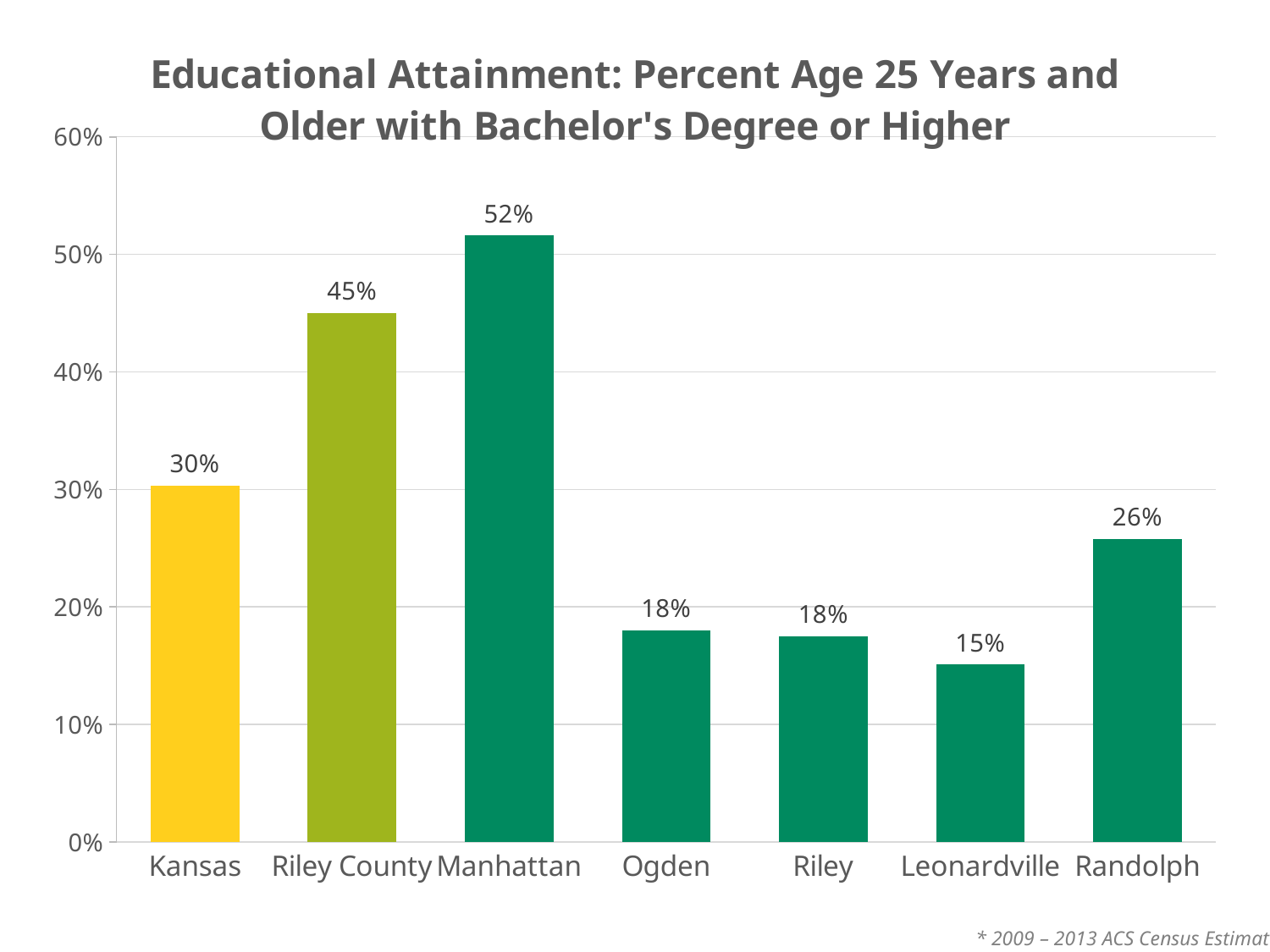
What is the value for Manhattan? 52% Which category has the lowest value? Leonardville What colour is the bar for Kansas? yellow What is the value for Randolph? 26% What kind of chart is shown on the slide? bar chart Which is larger, the value for Kansas or the value for Randolph? Kansas What is the value for Leonardville? 15% What is the difference between the values for Manhattan and Riley County? 7% Which category has the highest value? Manhattan How many categories are shown on the x axis? 7 Is the value for Riley County greater or less than 40%? greater What is the value for Kansas? 30%